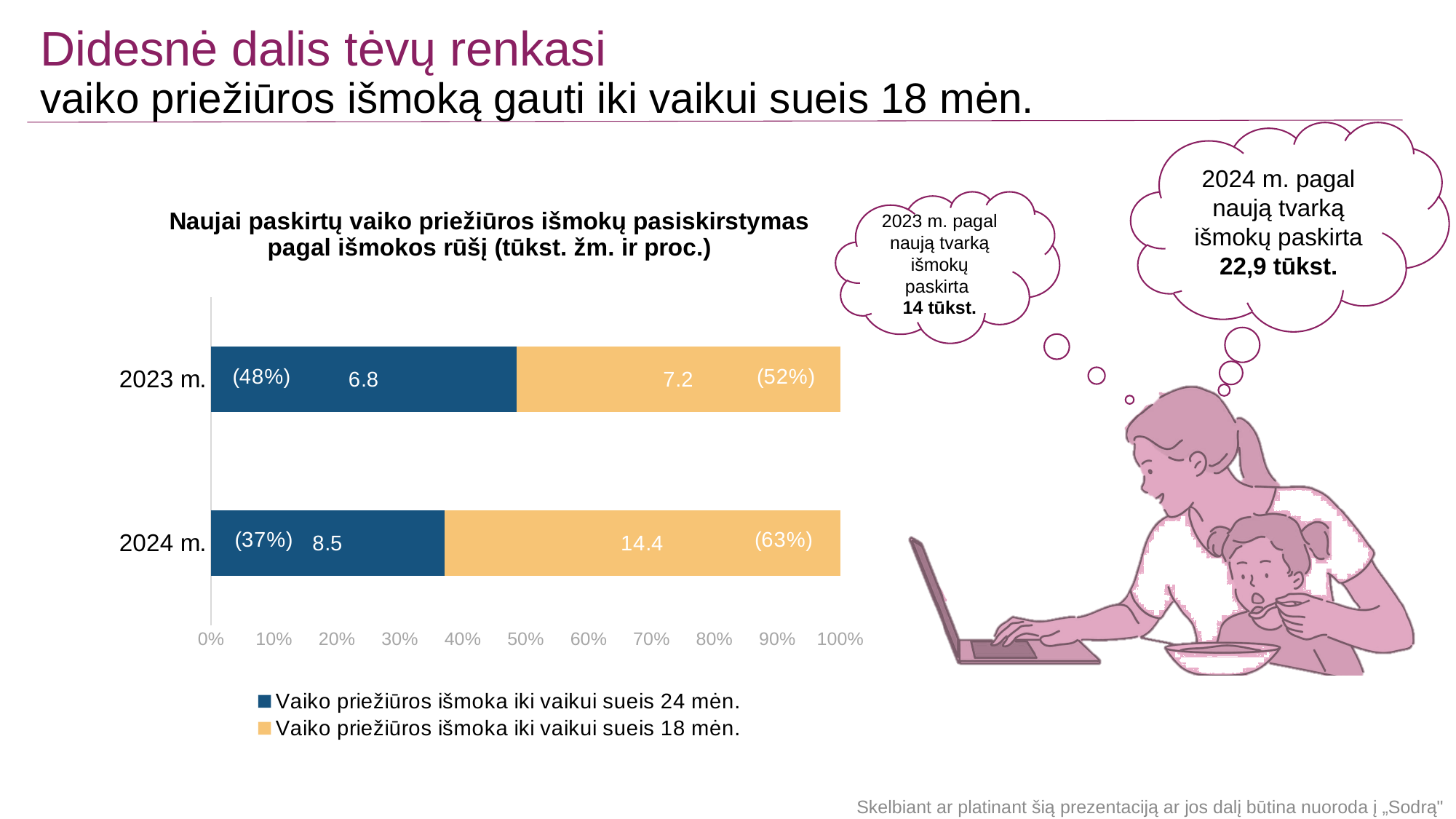
What is the value (tūkst. žm.) for 'Vaiko priežiūros išmoka iki vaikui sueis 24 mėn.' in 2023 m.? 6.8 Which series has the larger value in 2024 m.? Vaiko priežiūros išmoka iki vaikui sueis 18 mėn. What is the difference between the 18 mėn. value and the 24 mėn. value in 2024 m.? 5.9 How many year categories are plotted in the chart? 2 How many series does the chart legend list? 2 What percentage share does 'Vaiko priežiūros išmoka iki vaikui sueis 18 mėn.' have in 2023 m.? 52% What is the value (tūkst. žm.) for 'Vaiko priežiūros išmoka iki vaikui sueis 18 mėn.' in 2024 m.? 14.4 What kind of chart is shown on the slide? Stacked bar chart Does the share of 'Vaiko priežiūros išmoka iki vaikui sueis 24 mėn.' rise or fall from 2023 m. to 2024 m.? Fall What percentage share does 'Vaiko priežiūros išmoka iki vaikui sueis 24 mėn.' have in 2024 m.? 37% What is the title of the chart? Naujai paskirtų vaiko priežiūros išmokų pasiskirstymas pagal išmokos rūšį (tūkst. žm. ir proc.) What is the total of the 2023 m. bar (tūkst. žm.)? 14